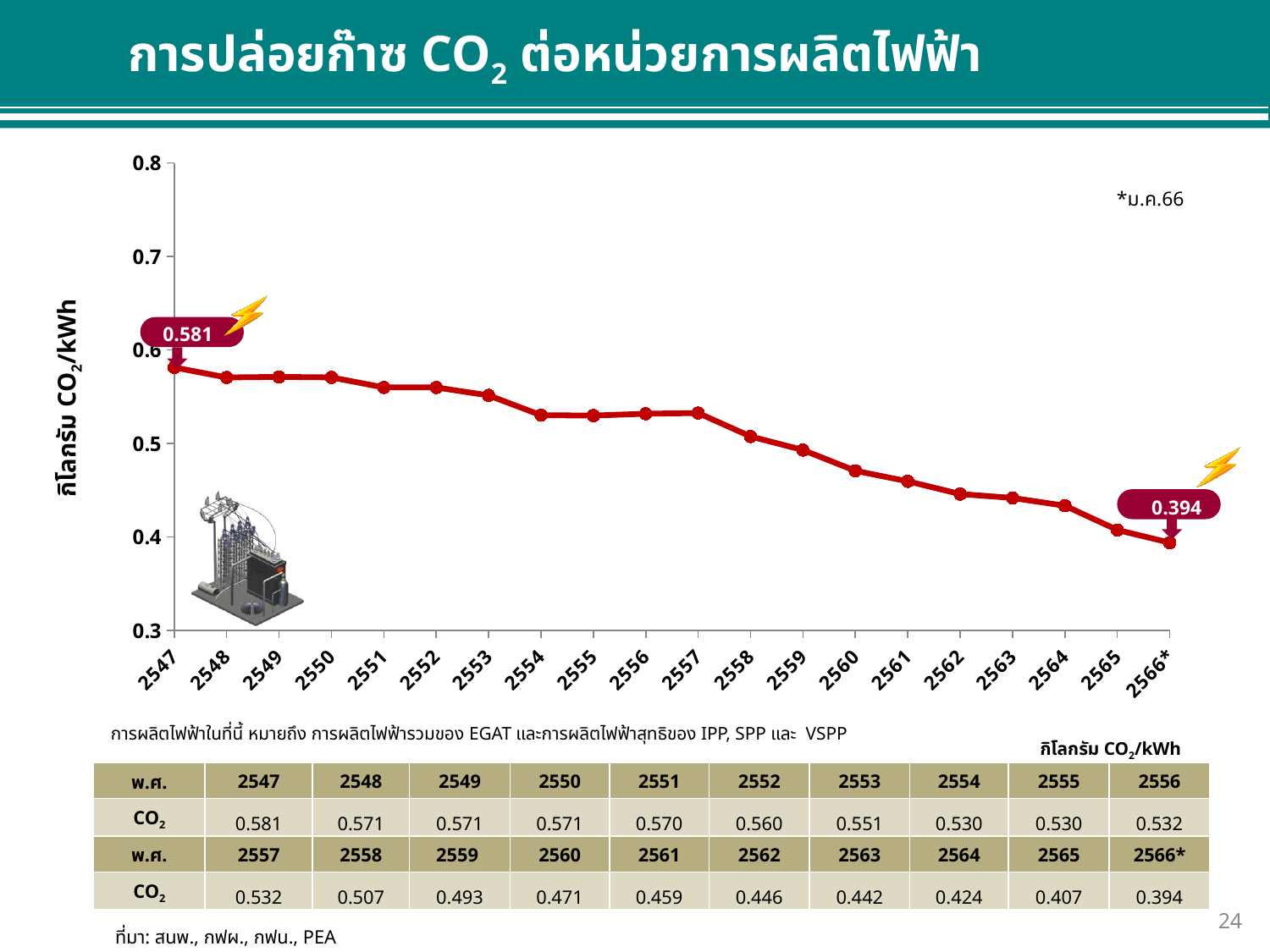
How many years are plotted on the x axis of the chart? 20 What is the CO2 emission value for the year 2547? 0.581 What is the difference between the CO2 emission values for 2557 and 2558? 0.025 What is the CO2 emission value for the year 2553? 0.551 Which year has the highest CO2 emission per kWh? 2547 What is the difference between the CO2 emission values for 2547 and 2566*? 0.187 What is the CO2 emission value for the year 2562? 0.446 Is the value for 2559 greater or less than 0.5? less What kind of chart is shown on the slide? line chart Which year has a higher CO2 emission value, 2560 or 2561? 2560 What is the CO2 emission value for the year 2566*? 0.394 Which year has the lowest CO2 emission per kWh? 2566*